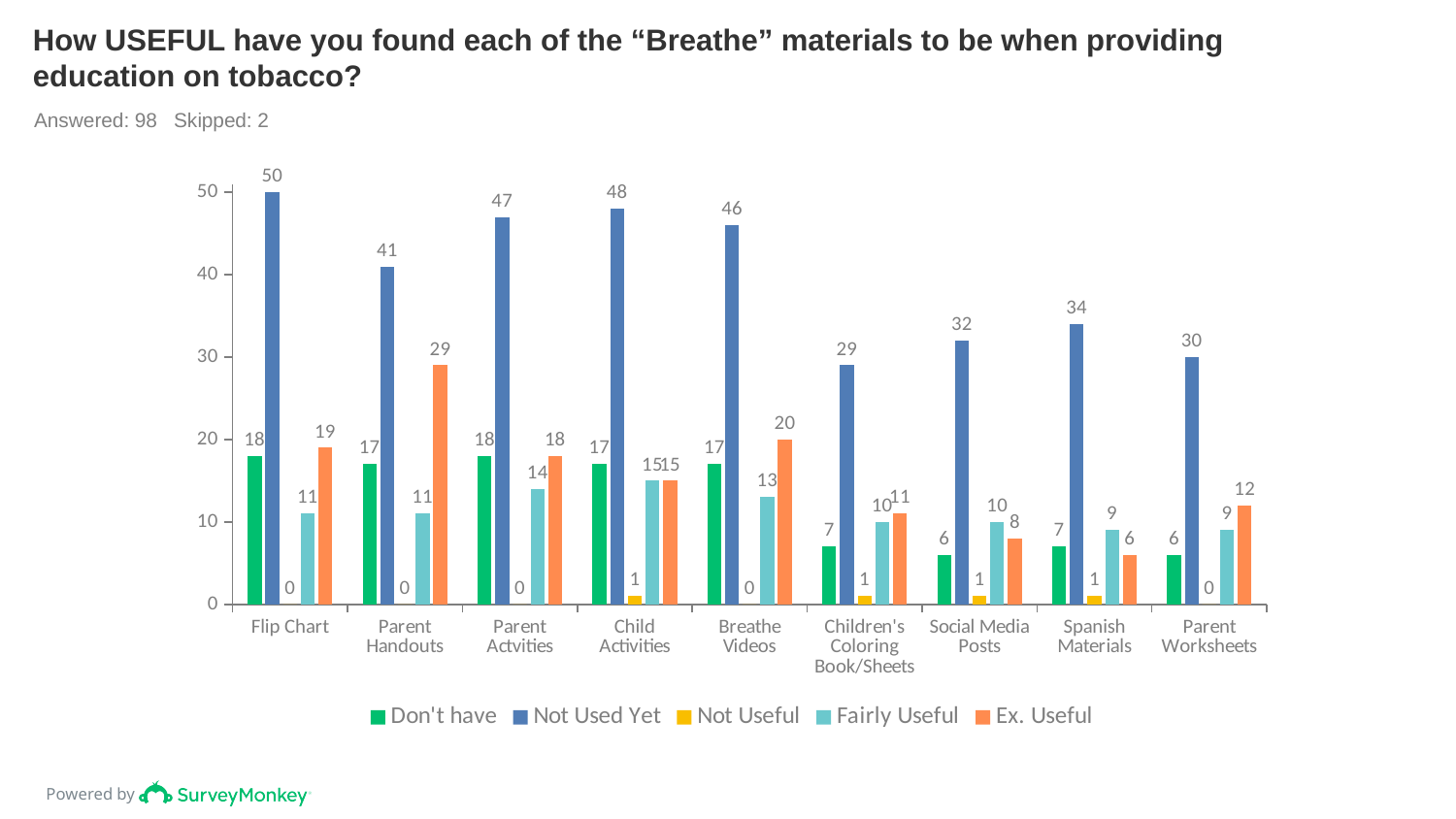
Which is larger, the "Ex. Useful" value for Breathe Videos or for Parent Worksheets? Breathe Videos Is the "Not Used Yet" value for Spanish Materials greater or less than 30? greater What is the "Don't have" value for Social Media Posts? 6 What is the "Not Used Yet" value for Flip Chart? 50 What is the "Ex. Useful" value for Parent Handouts? 29 How many series does the legend list? 5 What is the "Fairly Useful" value for Child Activities? 15 Which category has the highest "Not Used Yet" value? Flip Chart What is the difference between the "Not Used Yet" values for Child Activities and Breathe Videos? 2 What kind of chart is shown on the slide? Bar chart How many categories are shown on the x axis? 9 Which category has the lowest "Ex. Useful" value? Spanish Materials